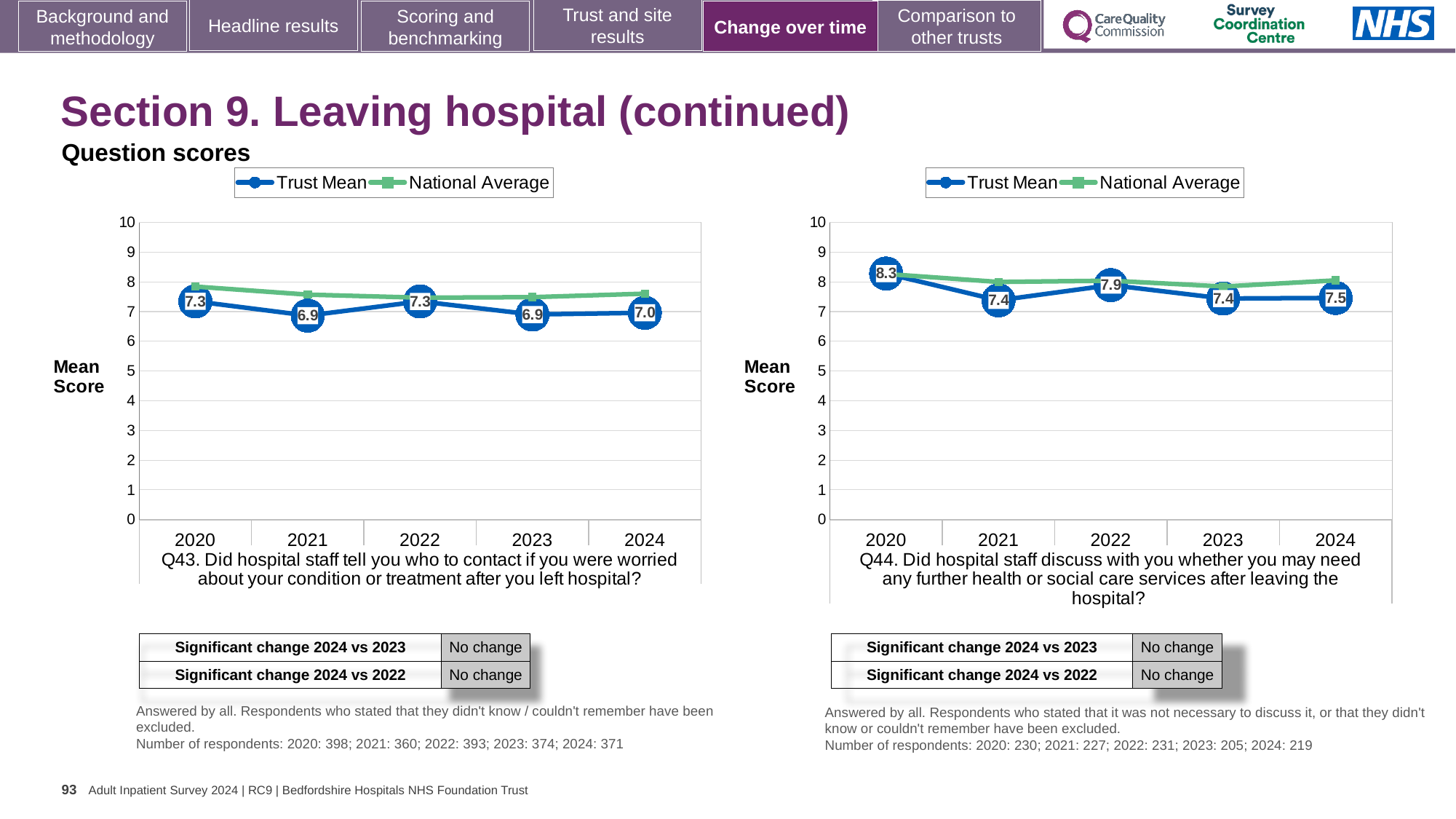
How many series does the legend of the Q43 chart on the left list? 2 In the Q43 chart on the left, what is the Trust Mean score for 2024? 7.0 In the Q43 chart on the left, is the National Average value for 2020 greater or less than 7? greater In the Q43 chart on the left, what is the difference between the Trust Mean scores for 2020 and 2021? 0.4 How many years are plotted on the x axis of the Q44 chart on the right? 5 In the Q44 chart on the right, what is the Trust Mean score for 2022? 7.9 In the Q44 chart on the right, what is the difference between the Trust Mean scores for 2020 and 2021? 0.9 In the Q44 chart on the right, which year has the highest Trust Mean score? 2020 In the Q44 chart on the right, is the National Average value for 2024 greater or less than 9? less In the Q43 chart on the left, which is larger, the Trust Mean score for 2022 or for 2024? 2022 What kind of chart is the Q44 chart on the right? Line chart In the Q43 chart on the left, what is the Trust Mean score for 2020? 7.3